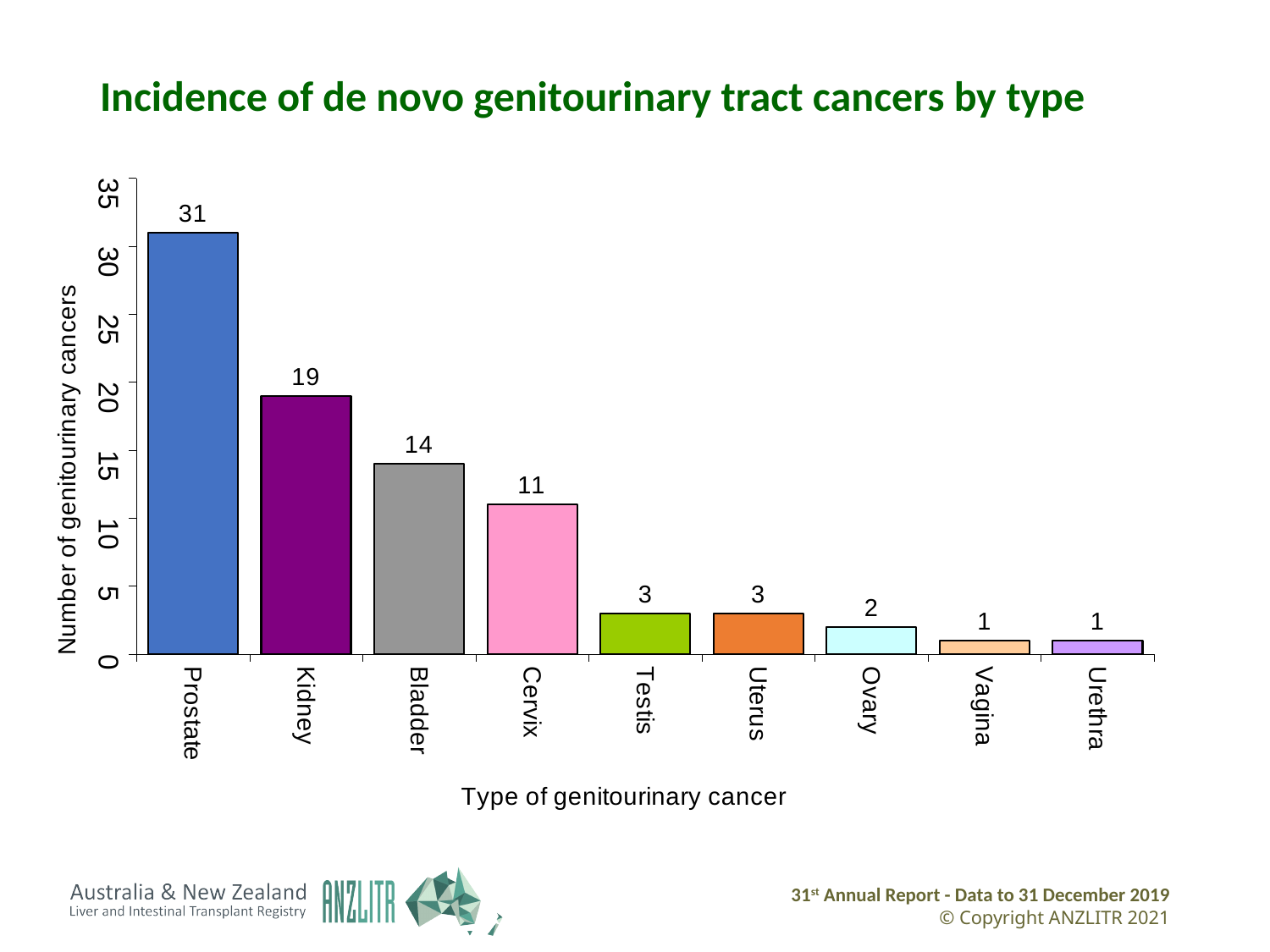
Which has more cases, Bladder or Cervix? Bladder What is the difference between the number of Kidney cancers and the number of Cervix cancers? 8 Do the values rise or fall moving from left to right along the x axis? Fall What is the number of genitourinary cancers for Prostate? 31 What is the number of genitourinary cancers for Bladder? 14 What is the label of the y axis? Number of genitourinary cancers Which type of genitourinary cancer has the highest number of cases? Prostate What is the title of the chart? Incidence of de novo genitourinary tract cancers by type What kind of chart is shown on the slide? Bar chart How many types of genitourinary cancer are shown on the x axis? 9 What is the number of genitourinary cancers for Ovary? 2 Is the value for Kidney greater or less than 15? greater